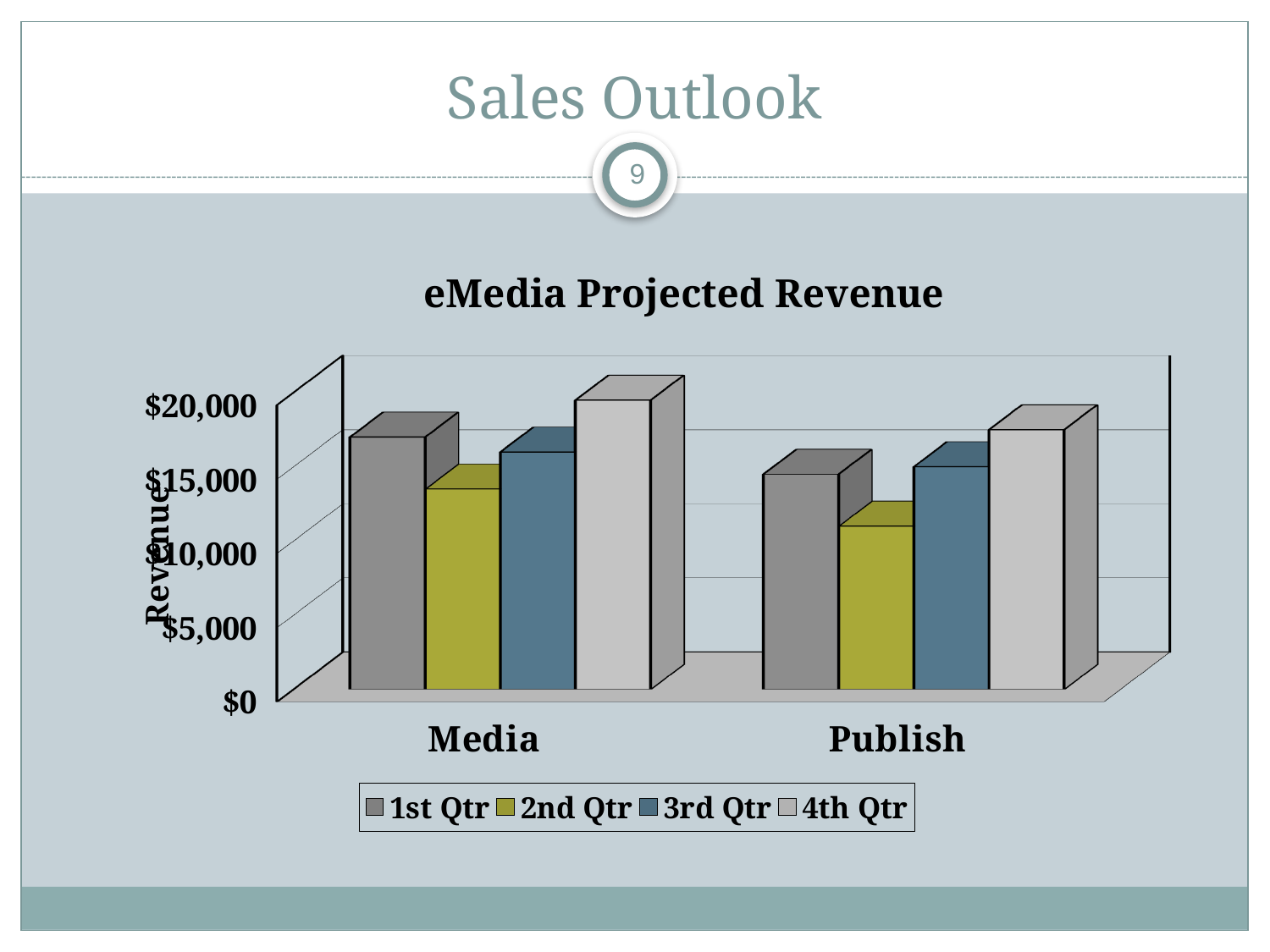
Is the 4th Qtr value for Media greater or less than $15,000? greater What is the title of the chart? eMedia Projected Revenue How many categories are shown on the x axis? 2 Is the 2nd Qtr value for Publish greater or less than $15,000? less Which quarter has the lowest value for Publish? 2nd Qtr What is the label on the vertical axis? Revenue Which quarter has the lowest value for Media? 2nd Qtr Which quarter has the highest value for Media? 4th Qtr How many series does the legend list? 4 What kind of chart is shown on the slide? bar chart Which quarter has the highest value for Publish? 4th Qtr Which is larger, the 4th Qtr value for Media or the 4th Qtr value for Publish? Media